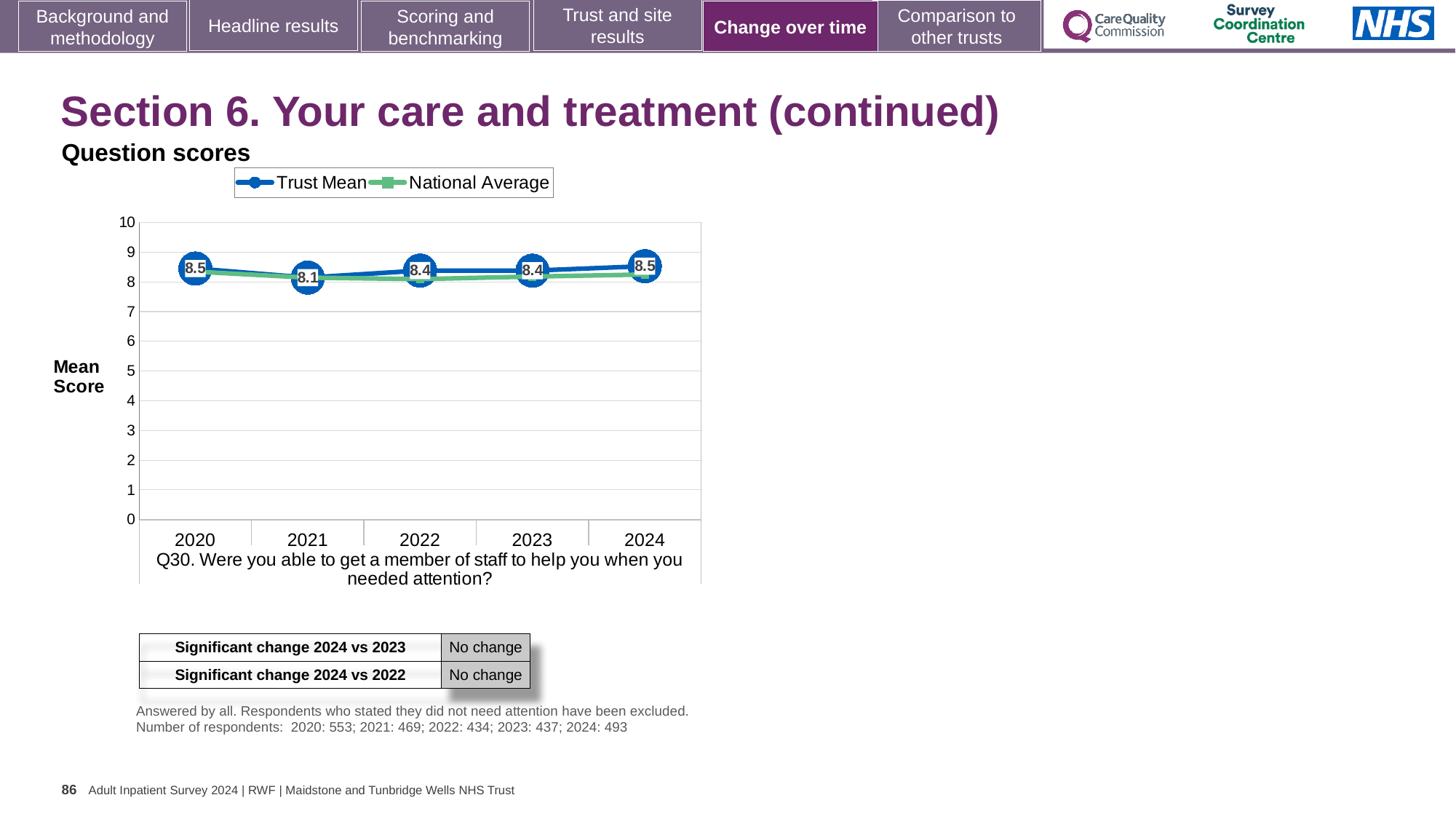
How many years are plotted on the x axis of the chart? 5 Does the Trust Mean score rise or fall from 2021 to 2024? Rise In which year is the Trust Mean score lowest? 2021 Which year has the larger Trust Mean score, 2021 or 2022? 2022 What kind of chart is shown on the slide? Line chart What is the Trust Mean score for 2021? 8.1 What is the Trust Mean score for 2020? 8.5 What is the Trust Mean score for 2023? 8.4 What is the difference between the Trust Mean scores for 2024 and 2021? 0.4 How many series does the chart legend list? 2 What is the Trust Mean score for 2024? 8.5 Is the National Average value for 2024 greater or less than 7? greater